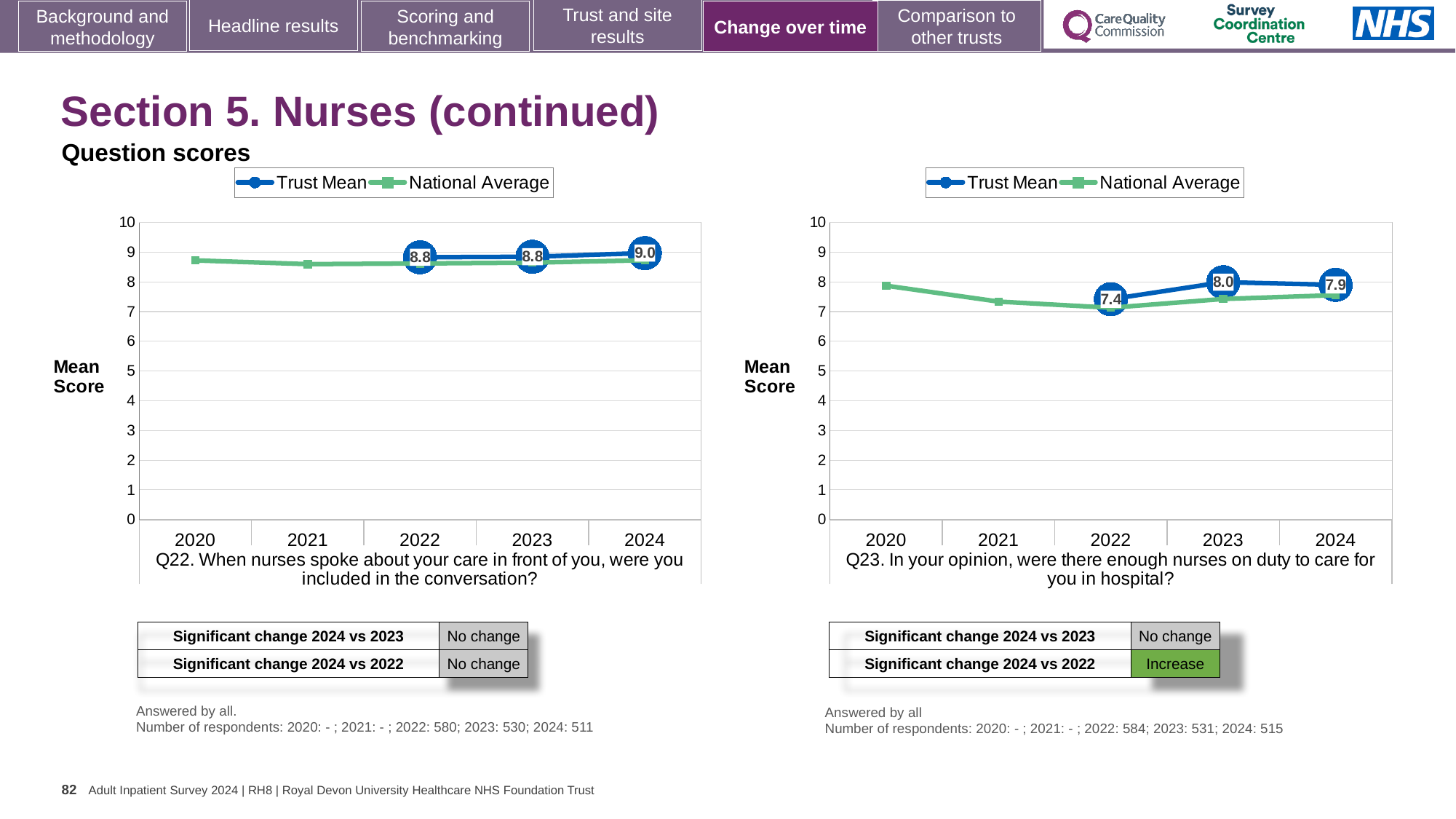
How many series does the legend of the Q22 chart on the left list? 2 In the Q23 chart on the right, what is the difference between the Trust Mean scores for 2023 and 2022? 0.6 In the Q23 chart on the right, what is the Trust Mean score for 2023? 8.0 In the Q22 chart on the left, is the National Average value for 2020 greater or less than 8? greater In the Q23 chart on the right, is the National Average value for 2021 greater or less than 8? less In the Q22 chart on the left, what is the Trust Mean score for 2022? 8.8 In the Q22 chart on the left, which year has the highest labelled Trust Mean score? 2024 In the Q22 chart on the left, what is the difference between the Trust Mean scores for 2024 and 2023? 0.2 In the Q23 chart on the right, what is the Trust Mean score for 2022? 7.4 What kind of chart is the Q23 chart on the right? Line chart In the Q22 chart on the left, what is the Trust Mean score for 2024? 9.0 In the Q23 chart on the right, which year has the lowest labelled Trust Mean score? 2022